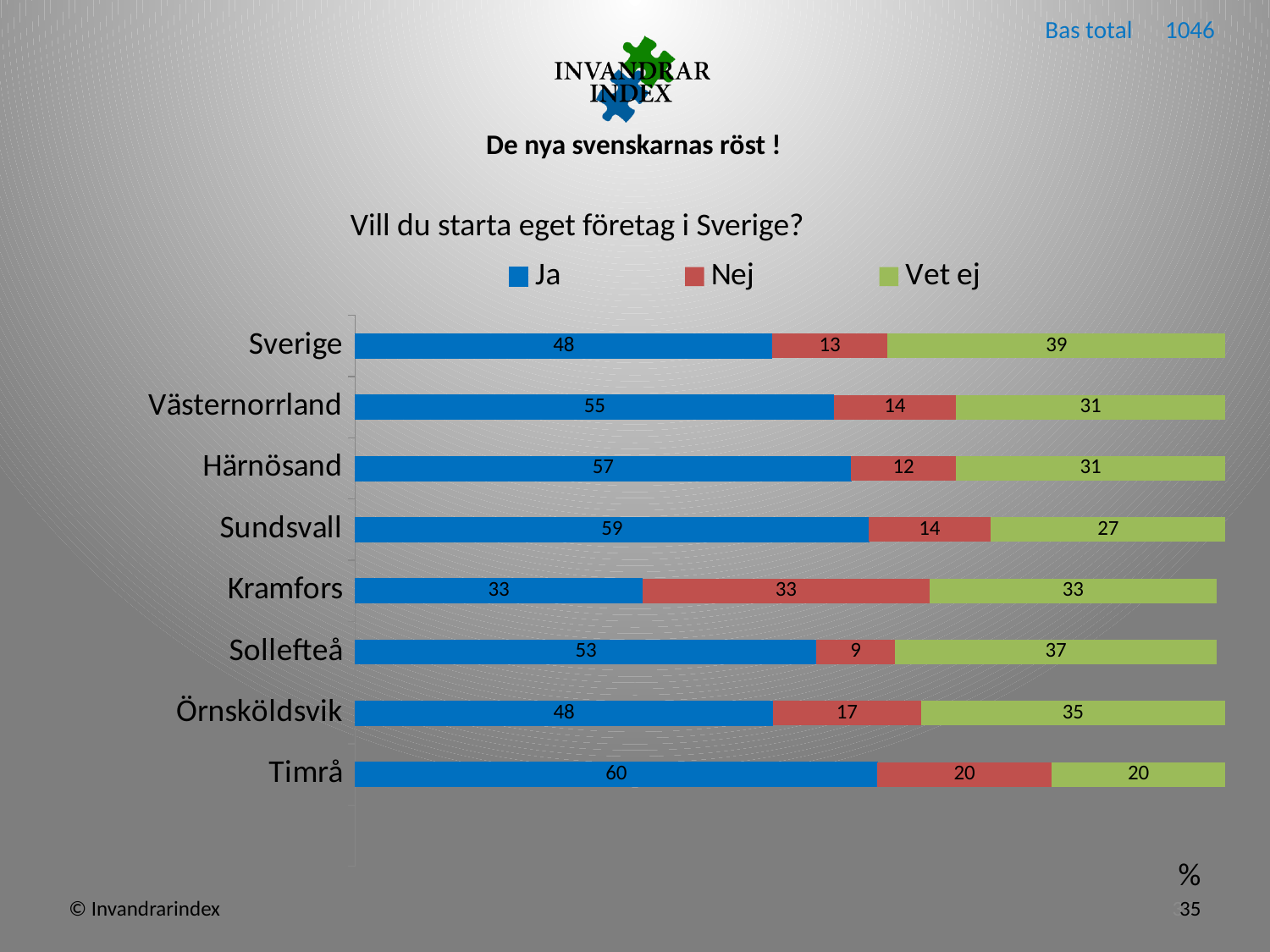
Which is larger, the Vet ej value for Sverige or for Västernorrland? Sverige What kind of chart is shown? Stacked bar chart How many categories are shown on the chart? 8 What is the value for Vet ej in Sollefteå? 37 What is the value for Ja in Sverige? 48 What is the value for Nej in Timrå? 20 Which category has the highest value for Nej? Kramfors What is the difference between the Ja values for Sundsvall and Härnösand? 2 Which category has the lowest value for Ja? Kramfors Which category has the highest value for Ja? Timrå What is the total of the stacked bar for Örnsköldsvik? 100 How many series does the legend list? 3